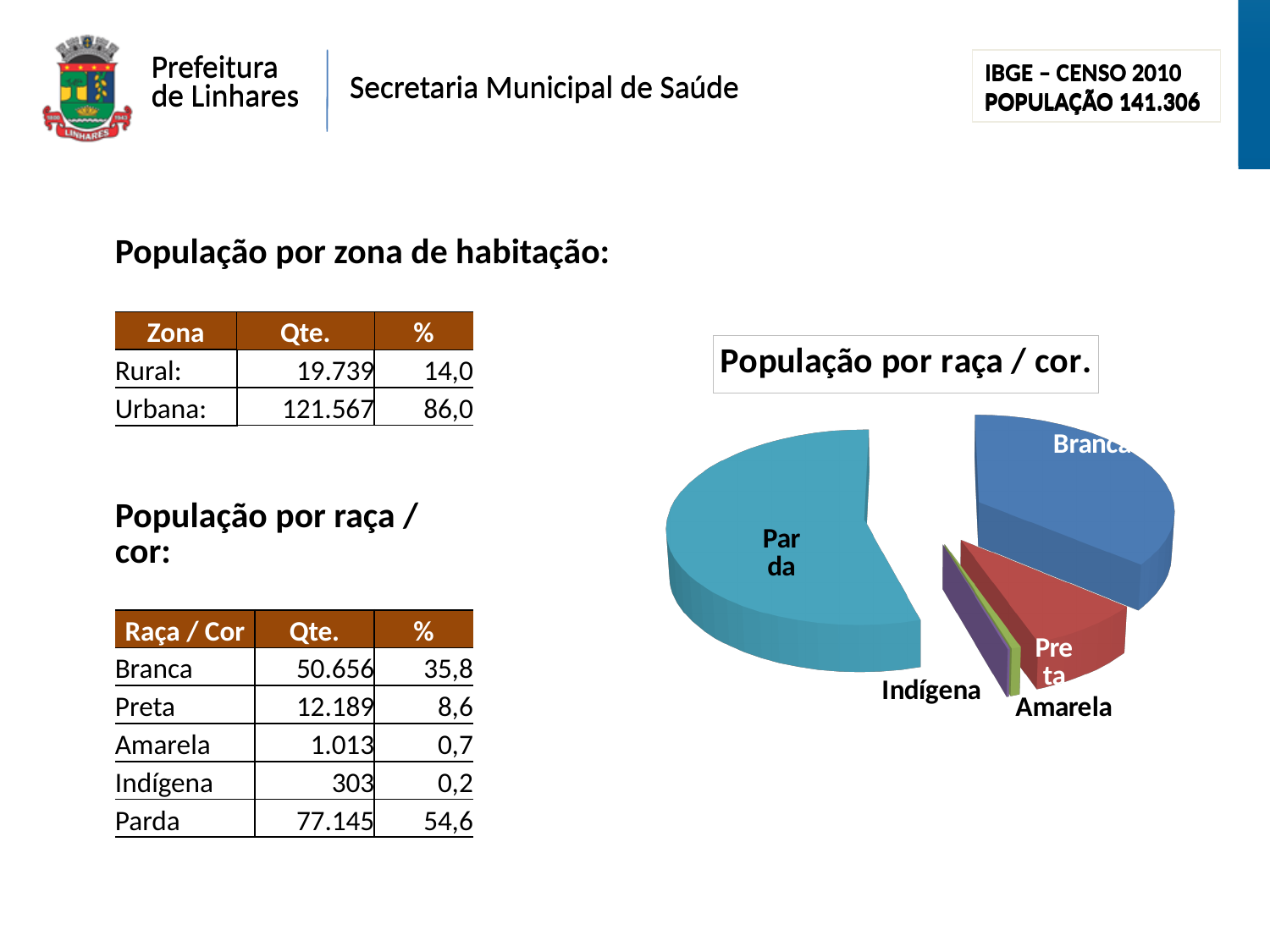
What is the title of the chart on the slide? População por raça / cor. Which slice is larger in the pie chart, Branca or Preta? Branca Which slice is larger in the pie chart, Branca or Parda? Parda What percentage share of the population is Parda according to the slide? 54,6 Which race/colour category has the largest slice in the pie chart? Parda What percentage share of the population is Branca according to the slide? 35,8 What kind of chart is shown on the slide? pie chart What colour is the Parda slice in the pie chart? light blue Which race/colour category has the smallest population according to the slide? Indígena What is the population quantity (Qte.) for Parda shown on the slide? 77.145 How many slices does the pie chart have? 5 What is the difference between the Branca and Preta population quantities shown on the slide? 38.467